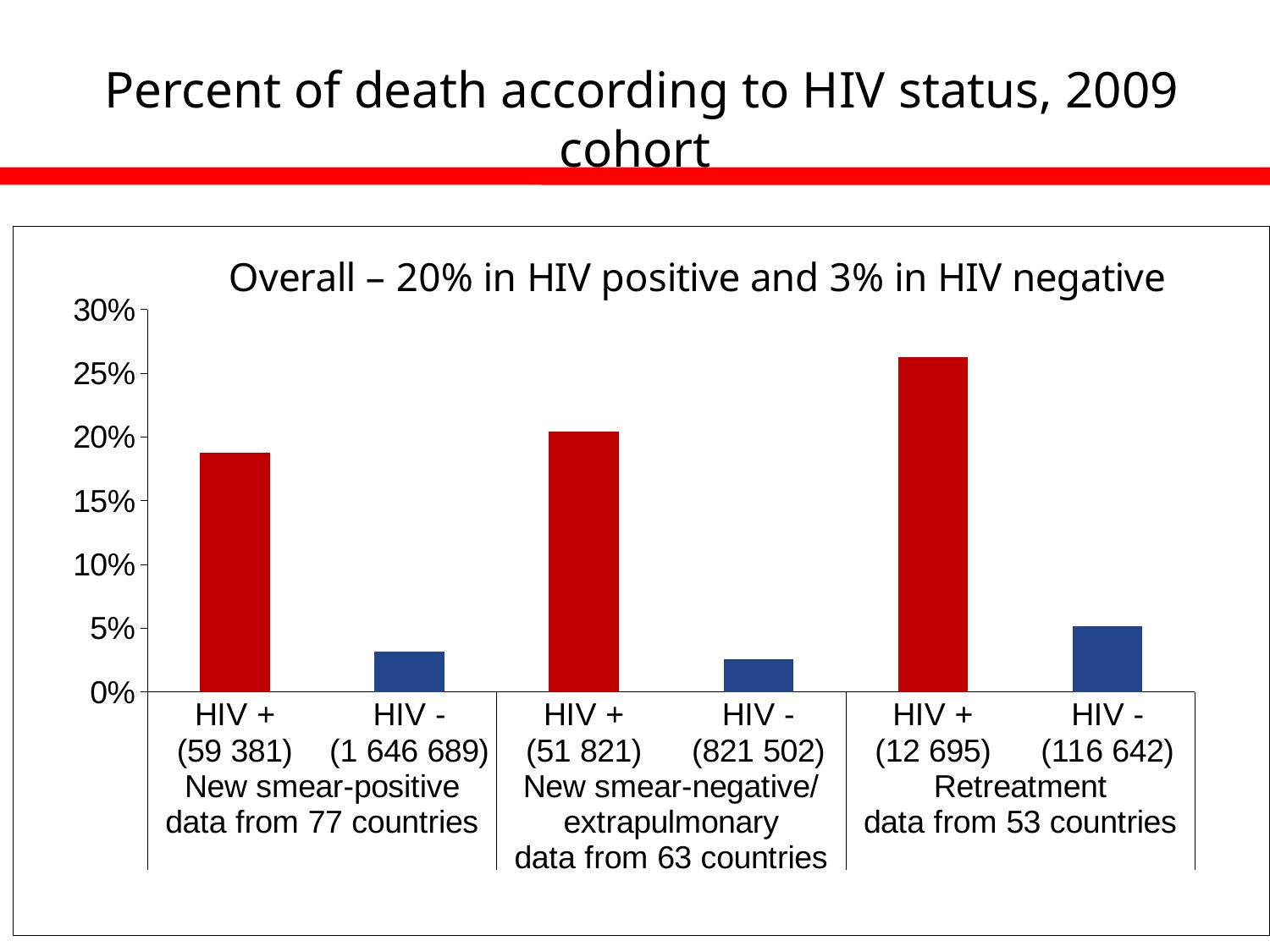
Which is larger: the value for HIV - in the Retreatment group or the value for HIV - in the New smear-negative/extrapulmonary group? HIV - in the Retreatment group Which is larger: the value for HIV + in the Retreatment group or the value for HIV + in the New smear-positive group? HIV + in the Retreatment group Is the value for HIV + in the New smear-positive group greater or less than 20%? less Which bar has the highest percent of death? HIV + (12 695) Retreatment Is the value for HIV - in the Retreatment group greater or less than 10%? less What colour are the HIV + bars in the chart? red What is the title shown above the chart? Overall – 20% in HIV positive and 3% in HIV negative What kind of chart is shown on the slide? bar chart How many bars are plotted in the chart? 6 Is the value for HIV - in the New smear-positive group greater or less than 5%? less